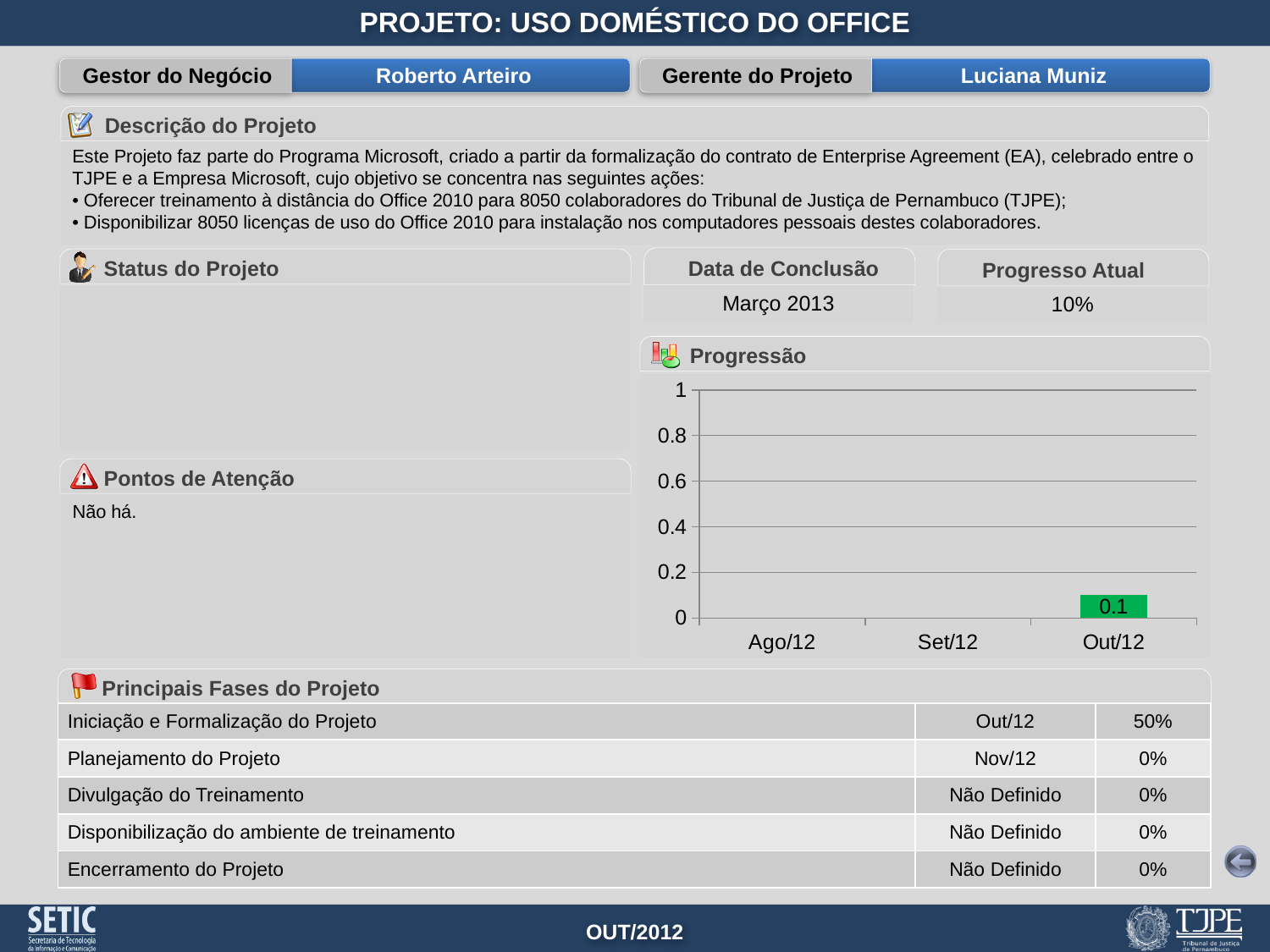
Is the value for Out/12 in the Progressão chart greater or less than 0.2? less What is the title of the chart on the slide? Progressão What kind of chart is the Progressão chart? bar chart What colour is the bar for Out/12 in the Progressão chart? green Which category has the highest value in the Progressão chart? Out/12 What is the highest value shown on the y axis of the Progressão chart? 1 How many categories are shown on the x axis of the Progressão chart? 3 Which category is the last on the x axis of the Progressão chart? Out/12 Is the value for Out/12 in the Progressão chart greater or less than 0.6? less What is the value for Out/12 in the Progressão chart? 0.1 Which category is the first on the x axis of the Progressão chart? Ago/12